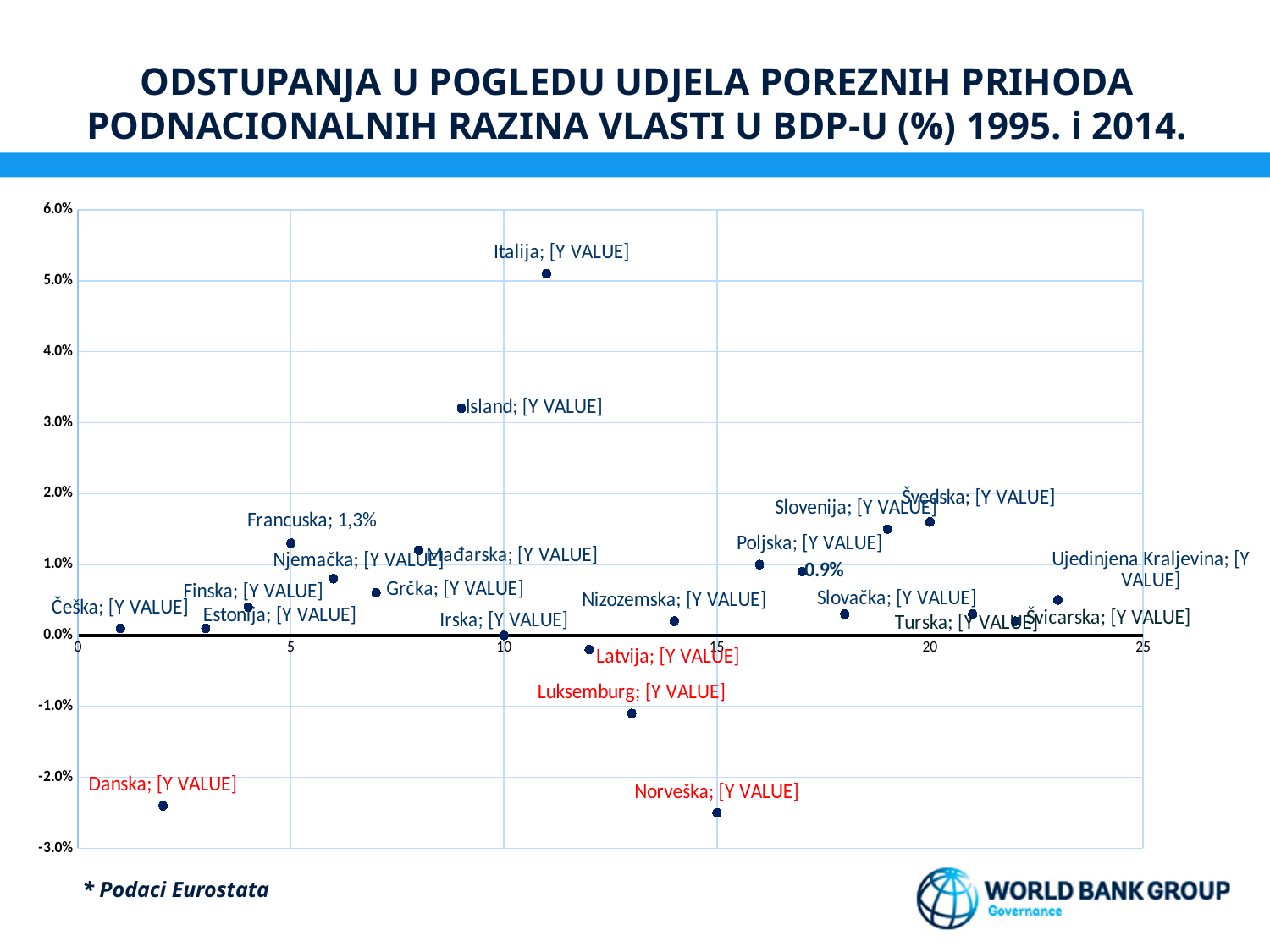
Which country has the highest value on the chart? Italija What is the highest value shown on the vertical axis? 6.0% Which has the larger value, Island or Francuska? Island Is the value for Italija greater or less than 4.0%? greater Is the value for Danska greater or less than -2.0%? less What value is printed for Francuska? 1,3% What is the source note printed below the chart? * Podaci Eurostata Is the value for Norveška greater or less than -2.0%? less Which has the larger value, Italija or Island? Italija How many country labels on the chart are shown in red? 4 What kind of chart is shown on the slide? scatter chart